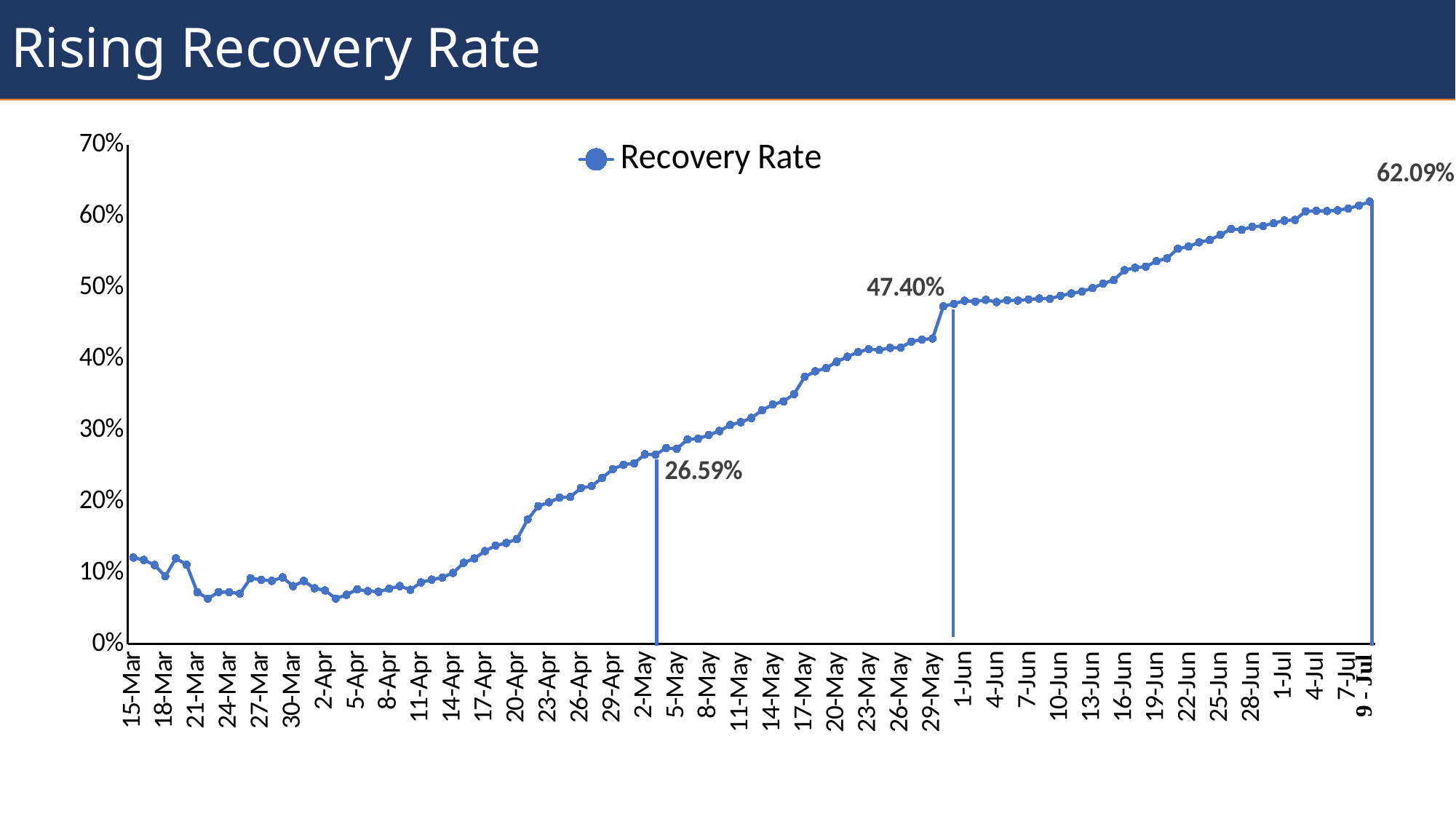
What is the difference between the labeled values 47.40% and 26.59%? 20.81 percentage points What type of chart is shown on the slide? line chart Which is larger, the recovery rate on 17-Apr or on 17-May? 17-May What is the highest data label shown on the chart? 62.09% Is the recovery rate on 2-Apr greater or less than 10%? less What is the recovery rate on 9-Jul, the last point of the chart? 62.09% What is the lowest of the three data labels printed on the chart? 26.59% Is the recovery rate on 15-Mar greater or less than 10%? greater How many series does the legend list? 1 Does the recovery rate generally rise or fall from 15-Mar to 9-Jul? rise What is the name of the series shown in the legend? Recovery Rate What is the difference between the labeled values 62.09% and 47.40%? 14.69 percentage points